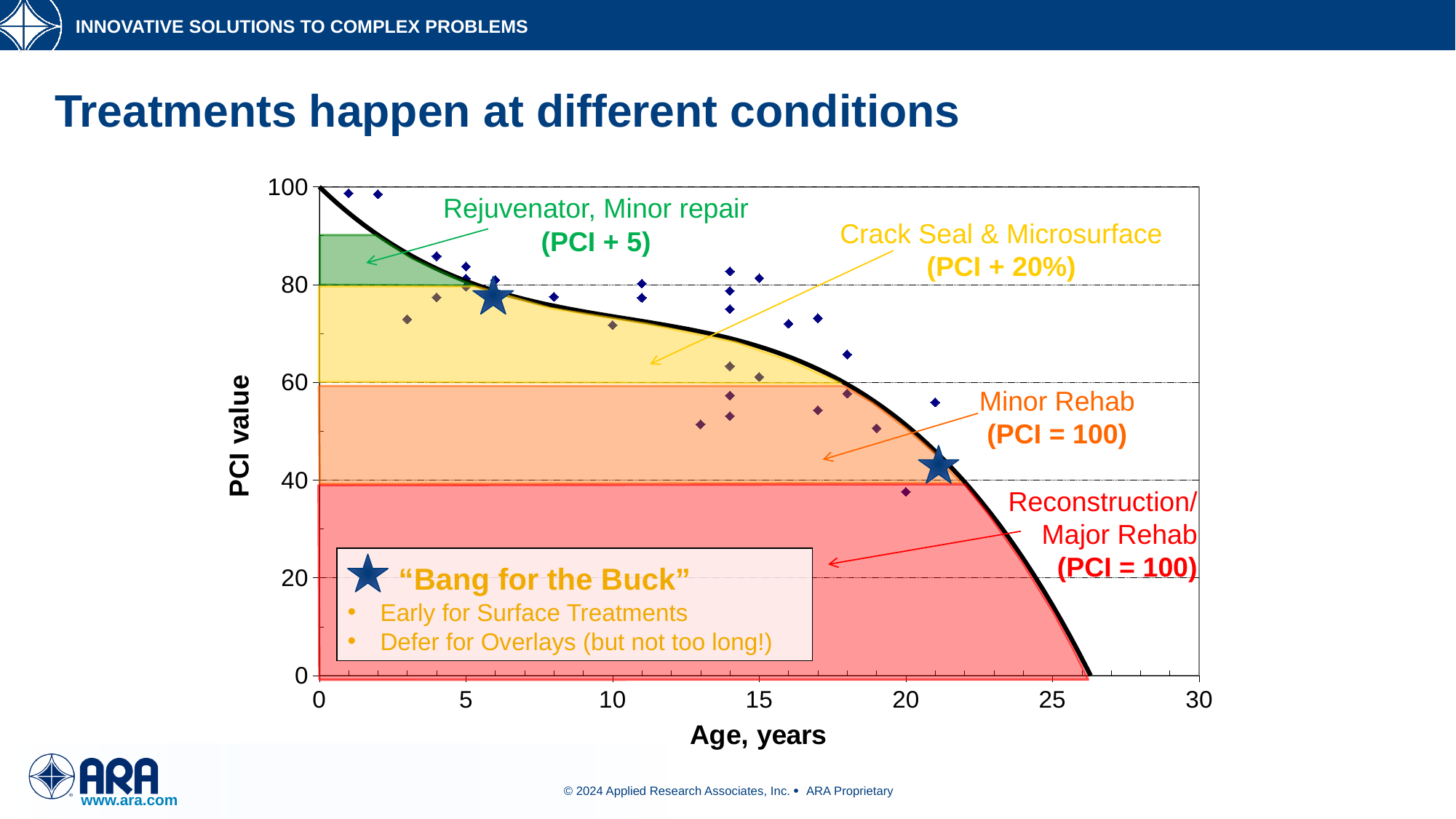
Is the PCI value of the curve at age 20 years greater or less than 80? less What is the PCI value of the curve at age 0 years? 100 Is the PCI value of the curve at age 5 years greater or less than 60? greater What is the label of the x axis? Age, years Is the PCI value of the curve at age 15 years greater or less than 40? greater Which is higher on the curve: the PCI value at age 5 years or at age 20 years? Age 5 years What is the highest value shown on the x axis? 30 What kind of chart is shown on the slide? Scatter chart with a trend line How many shaded treatment zones are shown on the chart? 4 Does the PCI value curve rise or fall as age increases? Fall